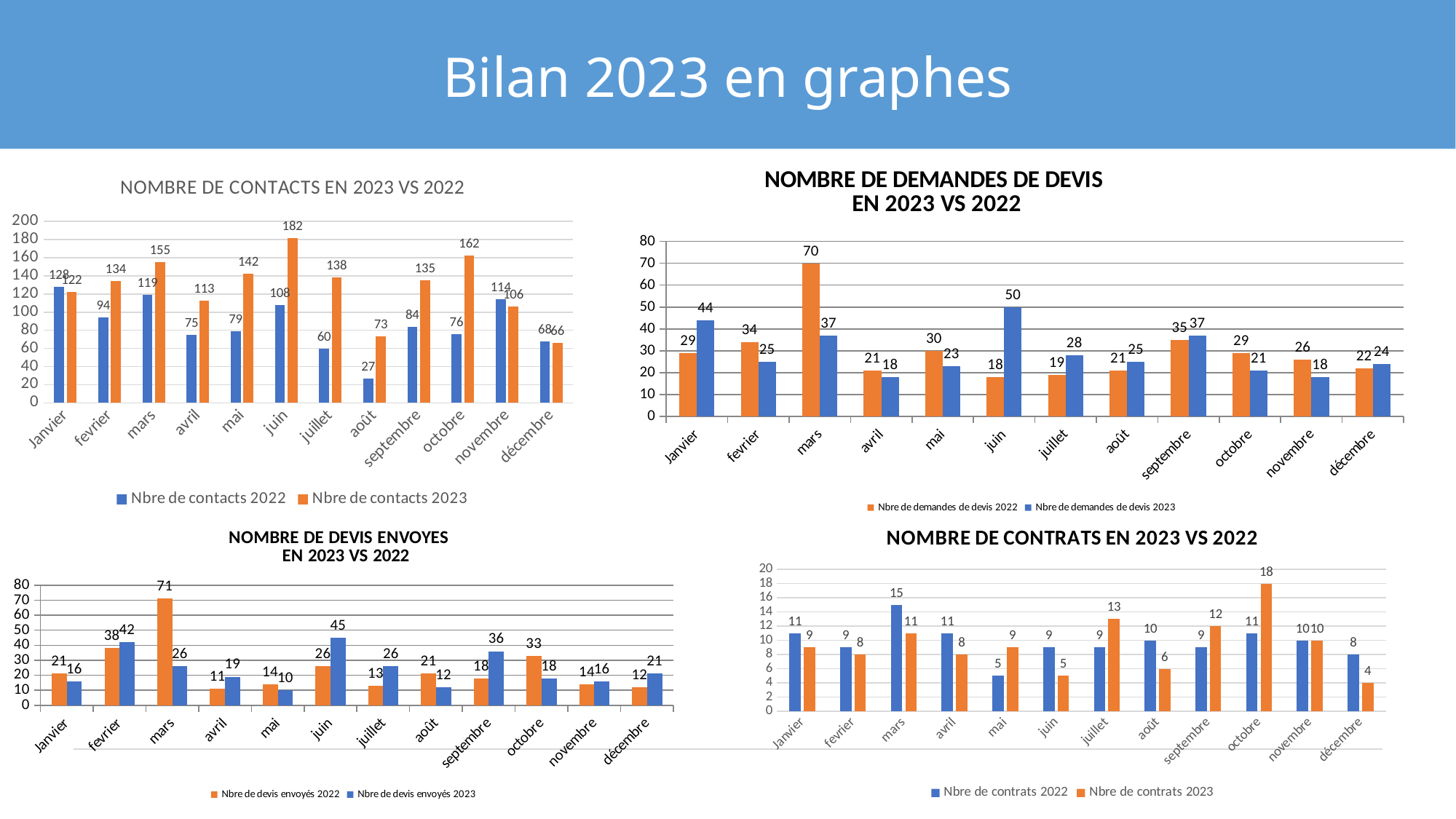
In the chart 'NOMBRE DE CONTACTS EN 2023 VS 2022', which month has the lowest value for Nbre de contacts 2022? août What kind of chart is 'NOMBRE DE CONTRATS EN 2023 VS 2022'? Bar chart In the chart 'NOMBRE DE DEVIS ENVOYES EN 2023 VS 2022', how many months are shown on the x axis? 12 In the chart 'NOMBRE DE CONTACTS EN 2023 VS 2022', what is the difference between Nbre de contacts 2023 and Nbre de contacts 2022 for octobre? 86 In the chart 'NOMBRE DE DEMANDES DE DEVIS EN 2023 VS 2022', which month has the highest value for Nbre de demandes de devis 2023? juin In the chart 'NOMBRE DE DEMANDES DE DEVIS EN 2023 VS 2022', what is the value of Nbre de demandes de devis 2022 for mars? 70 In the chart 'NOMBRE DE DEMANDES DE DEVIS EN 2023 VS 2022', which is larger for fevrier: Nbre de demandes de devis 2022 or Nbre de demandes de devis 2023? Nbre de demandes de devis 2022 In the chart 'NOMBRE DE CONTRATS EN 2023 VS 2022', what is the difference between Nbre de contrats 2022 and Nbre de contrats 2023 for décembre? 4 In the chart 'NOMBRE DE DEVIS ENVOYES EN 2023 VS 2022', which month has the highest value for Nbre de devis envoyés 2022? mars In the chart 'NOMBRE DE CONTACTS EN 2023 VS 2022', what is the value of Nbre de contacts 2023 for juin? 182 In the chart 'NOMBRE DE CONTRATS EN 2023 VS 2022', what is the value of Nbre de contrats 2023 for octobre? 18 In the chart 'NOMBRE DE DEVIS ENVOYES EN 2023 VS 2022', what is the value of Nbre de devis envoyés 2023 for septembre? 36